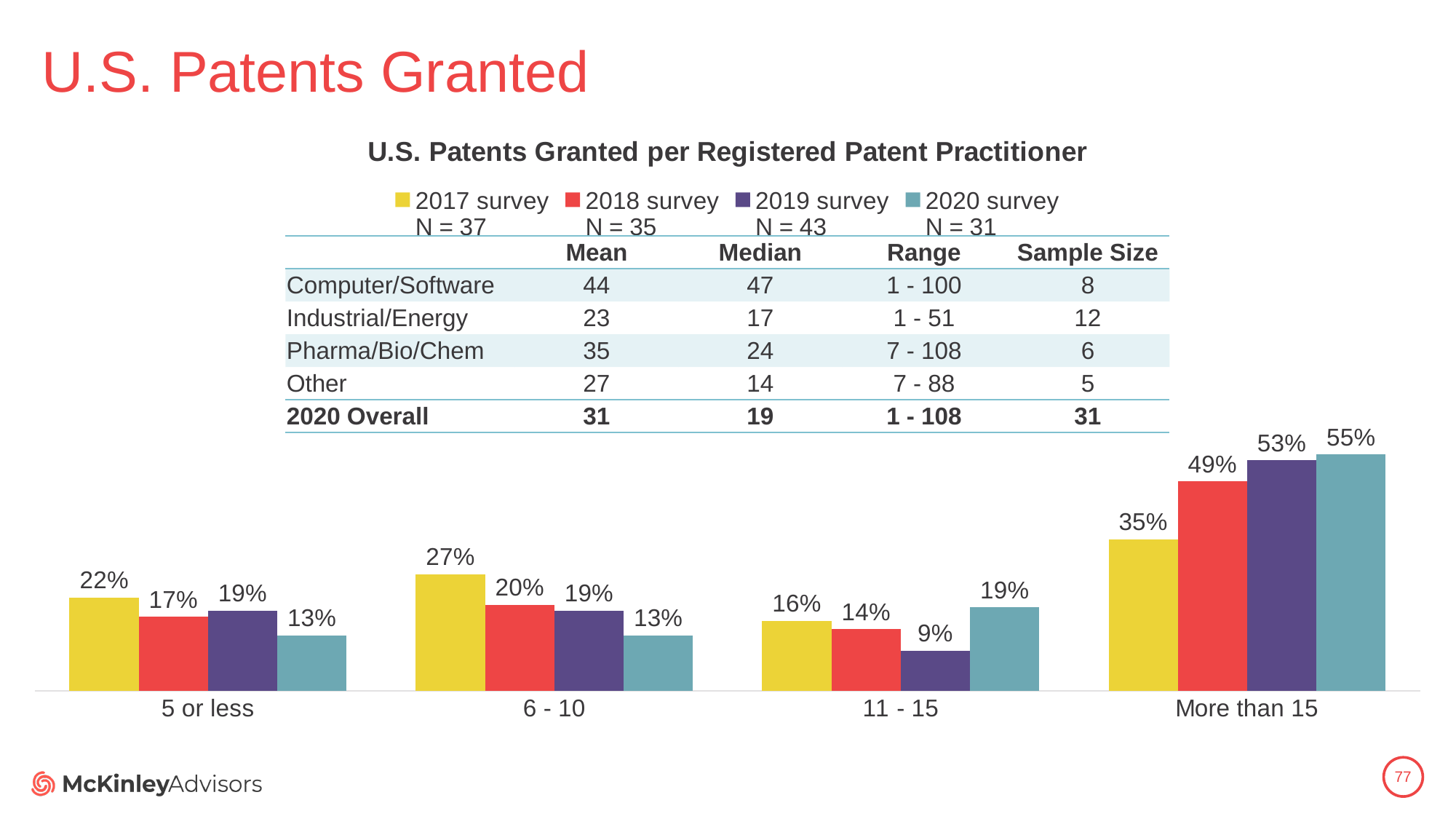
What is the value for the 2019 survey in the '11 - 15' category? 9% How many categories are shown on the x axis of the chart? 4 What is the difference between the 2020 survey and 2017 survey values in the 'More than 15' category? 20% What is the value for the 2017 survey in the '6 - 10' category? 27% Which category has the lowest value for the 2020 survey? 5 or less and 6 - 10 (tied at 13%) What is the title of the chart? U.S. Patents Granted per Registered Patent Practitioner Which category has the highest value for the 2018 survey? More than 15 What percentage of 2020 survey respondents reported more than 15 U.S. patents granted? 55% What type of chart is shown on the slide? Bar chart What is the sample size (N) for the 2019 survey shown in the legend? N = 43 How many series does the chart legend list? 4 In the '5 or less' category, which is larger: the 2017 survey value or the 2020 survey value? 2017 survey